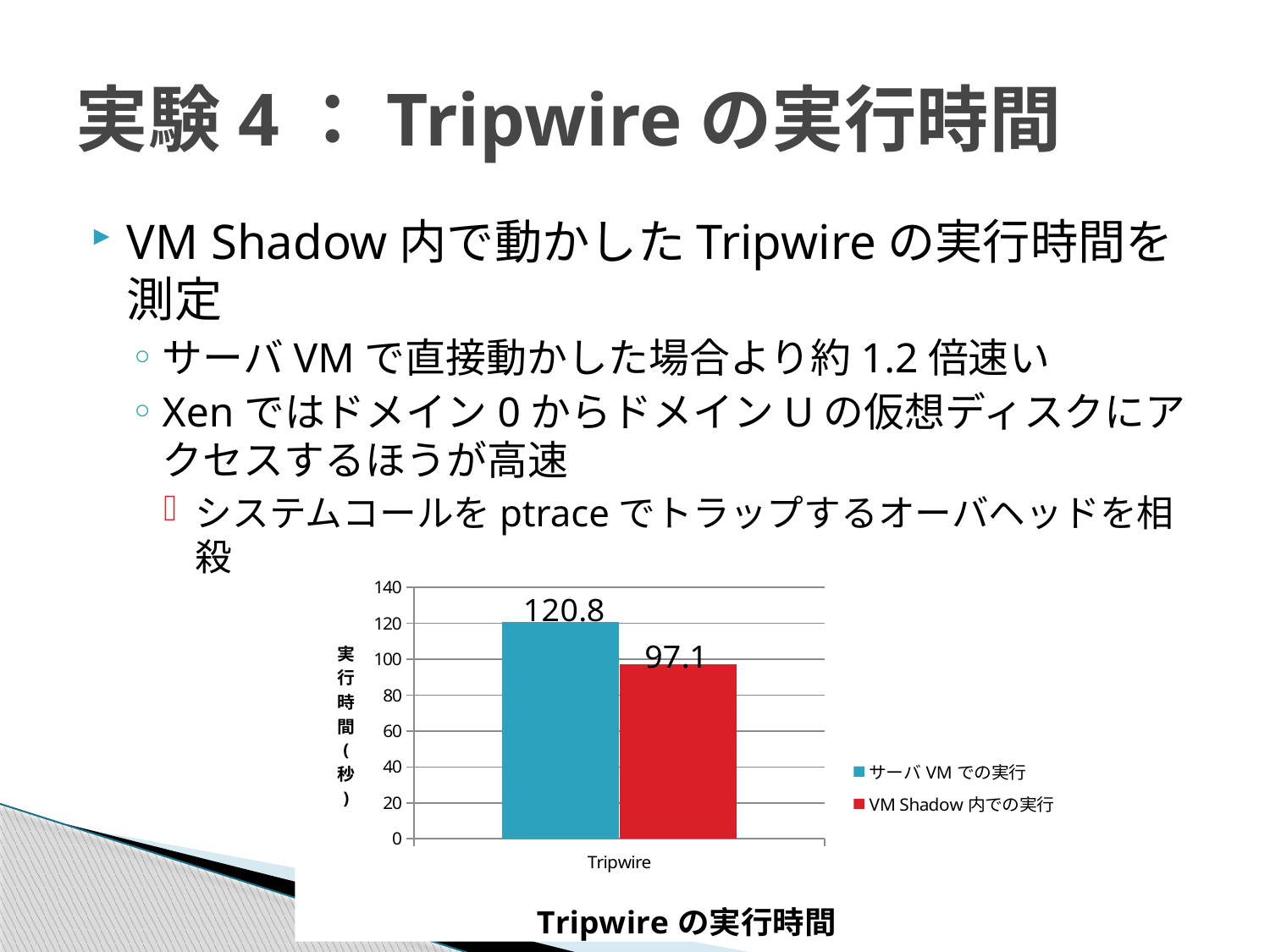
Which series has the lower execution time in the Tripwire の実行時間 chart? VM Shadow 内での実行 Is the execution time for サーバ VM での実行 larger or smaller than that for VM Shadow 内での実行? larger What is the label of the category on the x axis of the chart? Tripwire What is the execution time for サーバ VM での実行 in the Tripwire の実行時間 chart? 120.8 Is the value for サーバ VM での実行 greater or less than 100? greater Is the value for VM Shadow 内での実行 greater or less than 100? less What is the execution time for VM Shadow 内での実行 in the Tripwire の実行時間 chart? 97.1 What is the title of the chart on the slide? Tripwire の実行時間 What is the difference in execution time between サーバ VM での実行 and VM Shadow 内での実行? 23.7 What kind of chart is shown on the slide? bar chart How many series does the legend list in the chart? 2 Which series has the higher execution time in the Tripwire の実行時間 chart? サーバ VM での実行